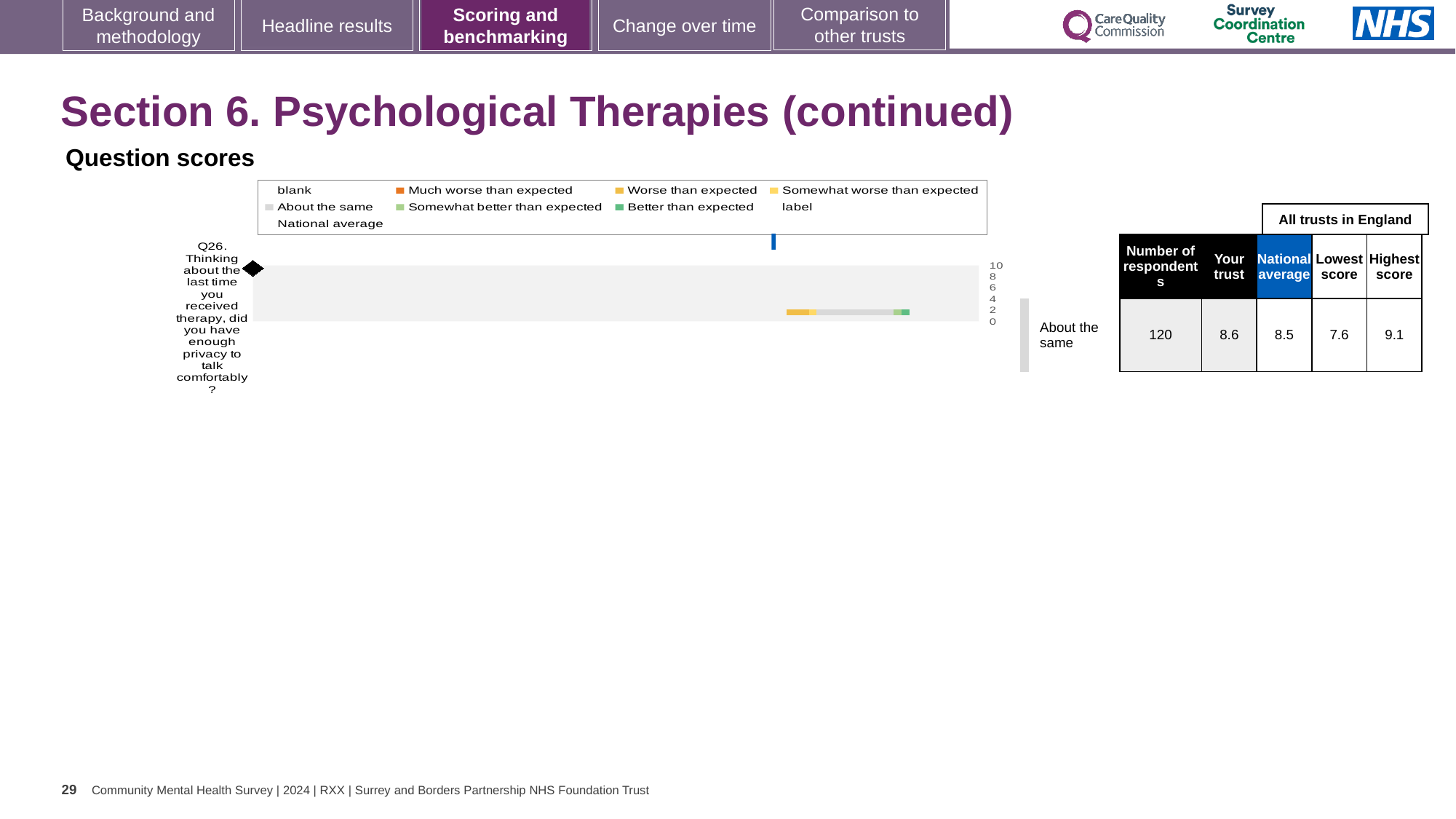
What benchmark category is the trust's Q26 score placed in? About the same What is the national average score for Q26? 8.5 What is the maximum value shown on the chart's score axis? 10 Which question is plotted on the chart? Q26. Thinking about the last time you received therapy, did you have enough privacy to talk comfortably? How many respondents answered Q26? 120 What is the 'Your trust' score for Q26? 8.6 How many questions (categories) are plotted on the chart? 1 What is the highest score among all trusts in England for Q26? 9.1 Which is larger for Q26, the trust's score or the national average? Your trust What kind of chart is used to show the Q26 question score? bar chart What is the lowest score among all trusts in England for Q26? 7.6 What is the difference between the highest and lowest scores for Q26 across all trusts in England? 1.5